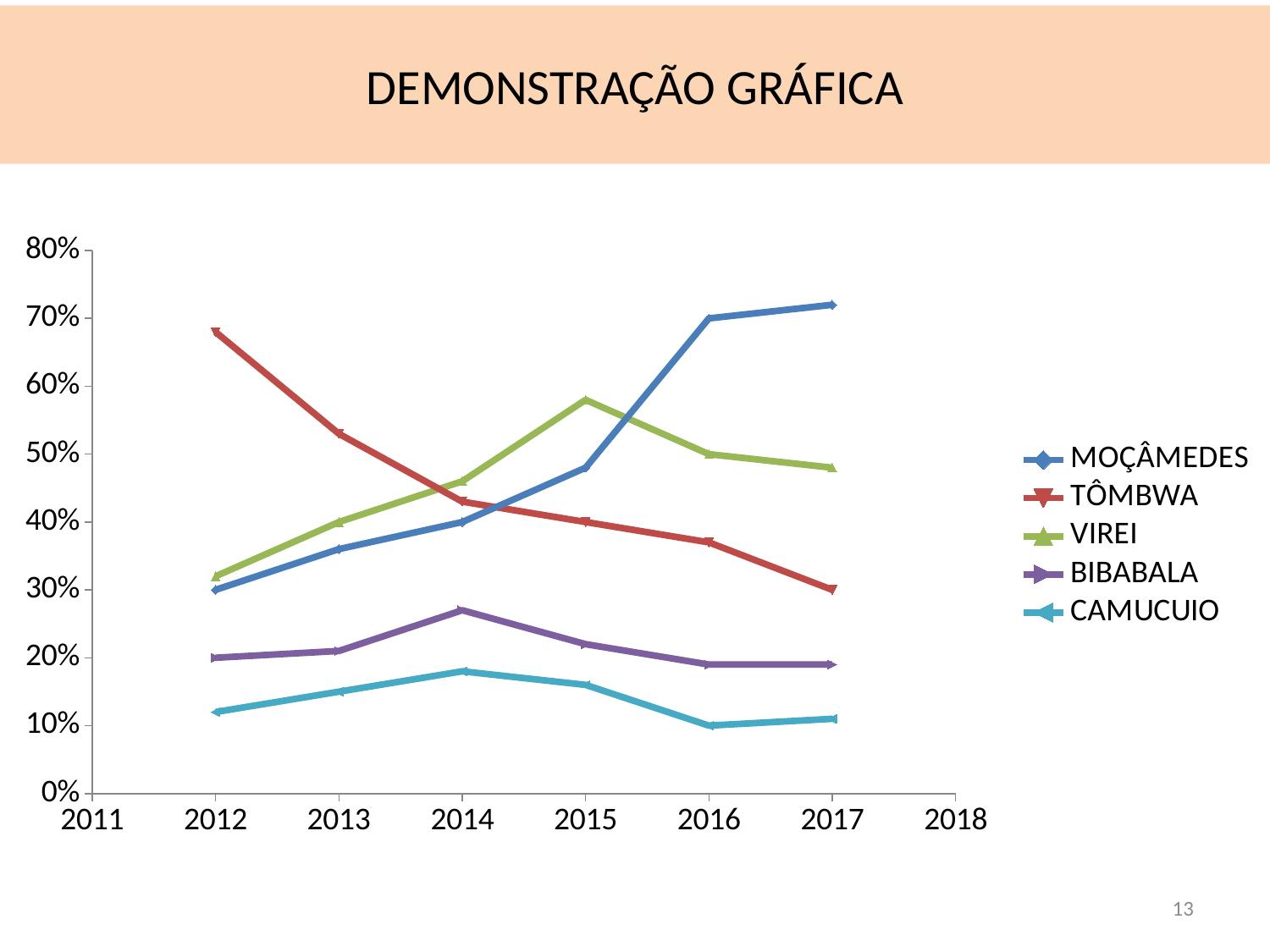
Is the value for CAMUCUIO in 2014 greater or less than 20%? less Does the value for MOÇÂMEDES rise or fall from 2012 to 2017? rise Which series has the lowest value in 2012? CAMUCUIO Is the value for VIREI in 2015 greater or less than 50%? greater What kind of chart is shown on the slide? line chart How many years have data points plotted on the chart? 6 Which series has the highest value in 2012? TÔMBWA How many series does the legend list? 5 Which series has the highest value in 2017? MOÇÂMEDES Is the value for TÔMBWA in 2012 greater or less than 60%? greater Does the value for TÔMBWA rise or fall from 2012 to 2017? fall Which is larger in 2015, the value for VIREI or the value for MOÇÂMEDES? VIREI